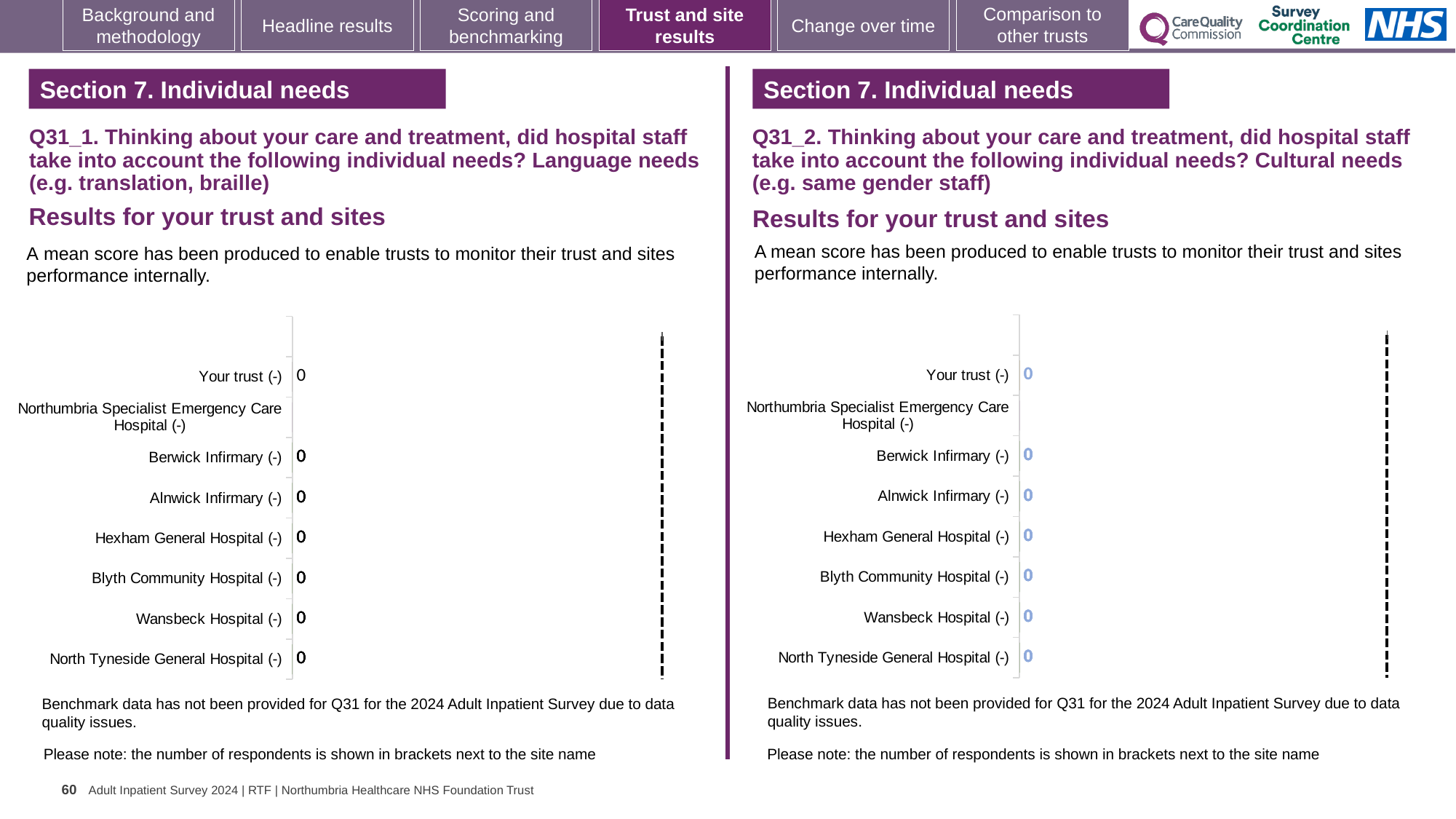
Which category in the left chart (Q31_1, Language needs) has no data label shown next to it? Northumbria Specialist Emergency Care Hospital (-) Which category appears first (at the top) of the right chart (Q31_2, Cultural needs)? Your trust (-) In the right chart (Q31_2, Cultural needs), what is the value shown for Your trust? 0 In the right chart (Q31_2, Cultural needs), what is the value shown for Hexham General Hospital? 0 In the left chart (Q31_1, Language needs), what is the value shown for Your trust? 0 In the left chart (Q31_1, Language needs), what is the value shown for Berwick Infirmary? 0 How many categories are listed on the vertical axis of the right chart (Q31_2, Cultural needs)? 8 In the left chart (Q31_1, Language needs), what is the difference between the values for Alnwick Infirmary and Blyth Community Hospital? 0 What kind of chart is the left chart (Q31_1, Language needs)? Bar chart How many categories are listed on the vertical axis of the left chart (Q31_1, Language needs)? 8 In the right chart (Q31_2, Cultural needs), what is the value shown for Wansbeck Hospital? 0 In the left chart (Q31_1, Language needs), what is the value shown for North Tyneside General Hospital? 0